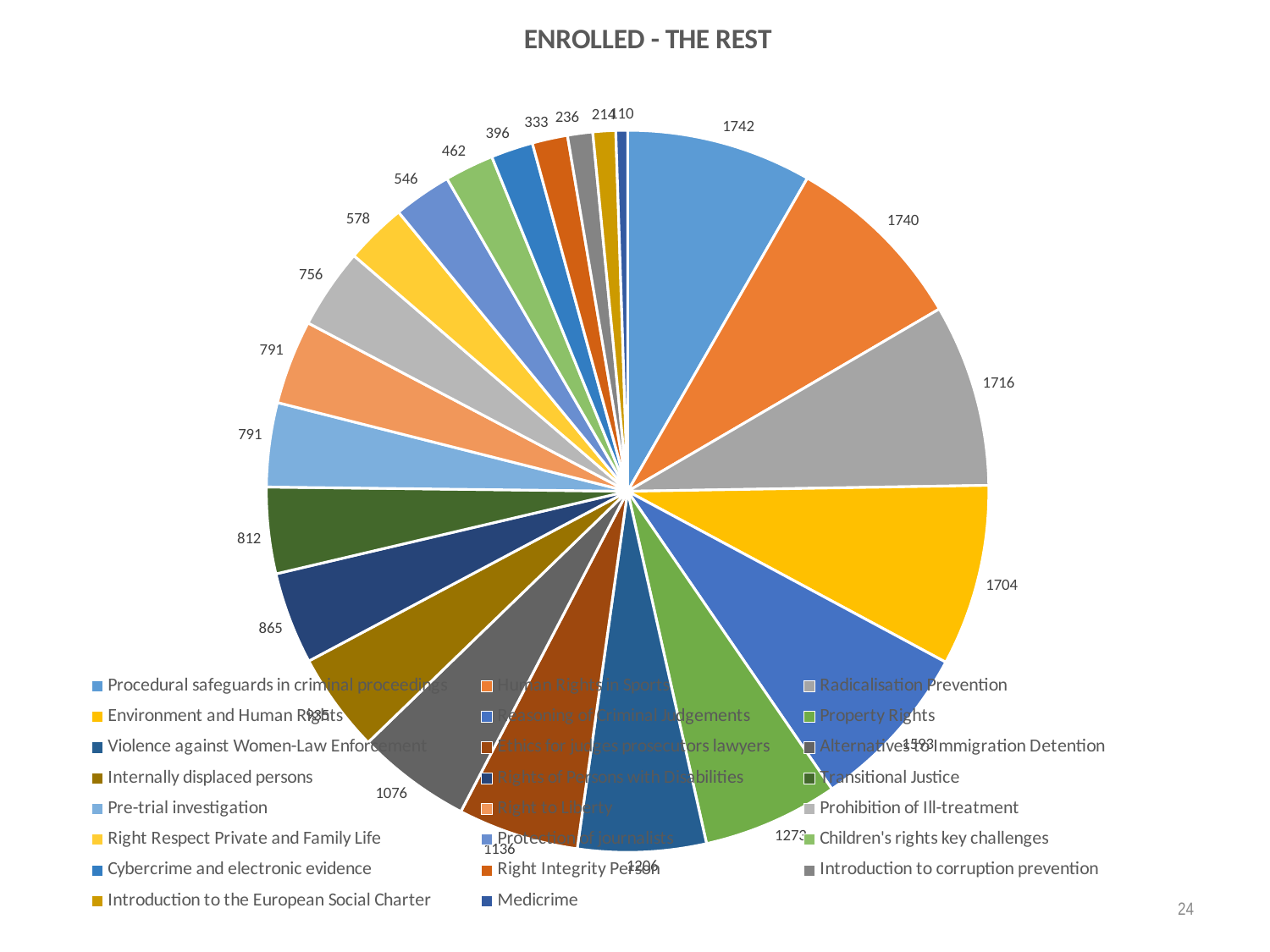
What is the value for Environment and Human Rights? 1704 What is the value for Medicrime? 110 What is the title of the chart? ENROLLED - THE REST Which category has the smallest slice of the pie? Medicrime How many categories does the legend of the pie chart list? 23 What is the difference between the values for Procedural safeguards in criminal proceedings and Radicalisation Prevention? 26 Which category has the largest slice of the pie? Procedural safeguards in criminal proceedings Which is larger, the value for Property Rights or the value for Transitional Justice? Property Rights What is the value for Radicalisation Prevention? 1716 What is the value for Transitional Justice? 812 What is the value for Property Rights? 1273 What kind of chart is shown on the slide? pie chart